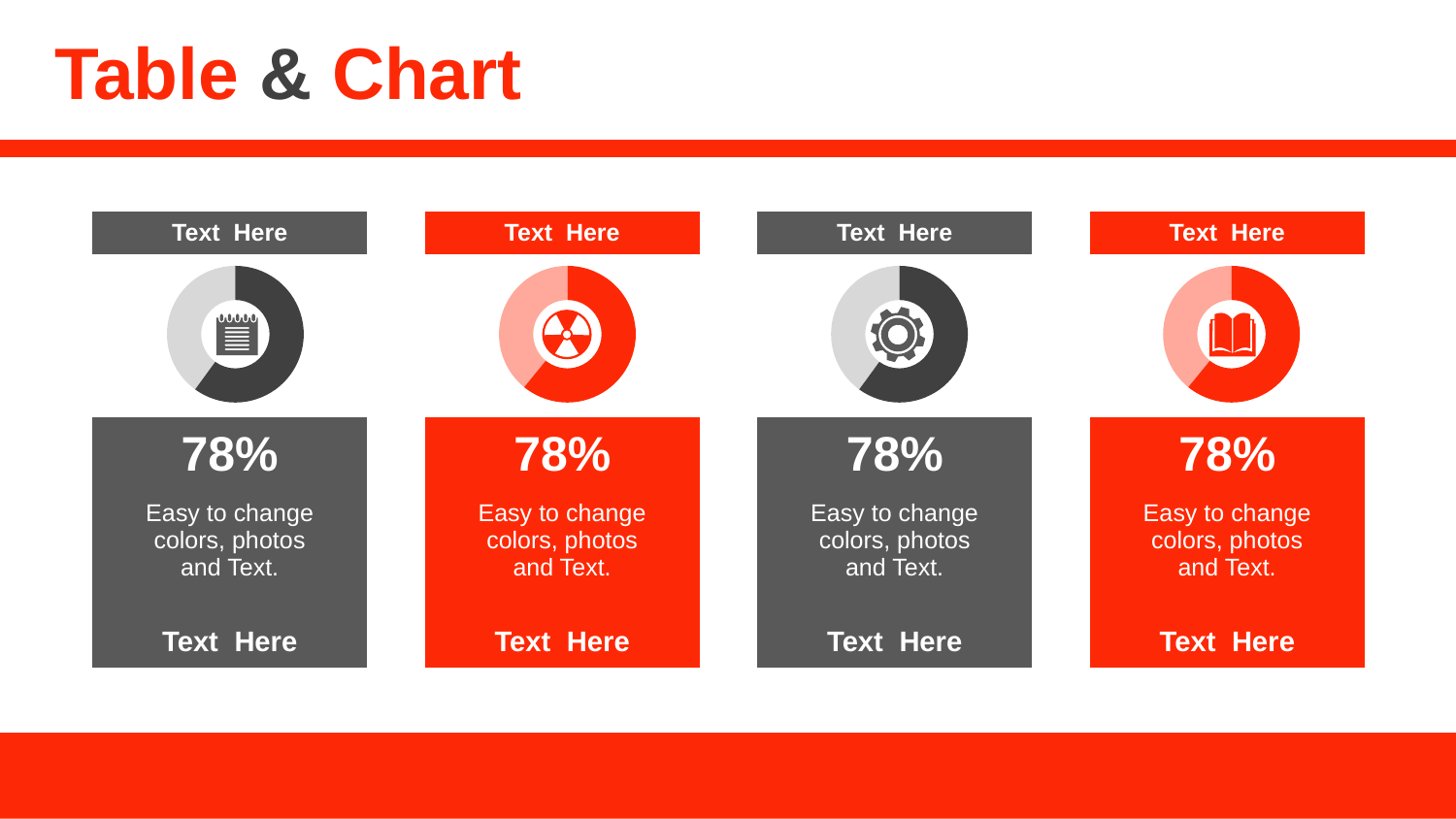
What is the header label printed above each donut chart? Text Here How many donut charts are shown on the slide? 4 How many segments does each donut chart have? 2 What colour is the larger segment of the second donut chart from the left? Red What percentage is printed below the leftmost donut chart? 78% Is the value shown for the leftmost donut chart greater or less than 50%? greater What percentage is printed below the third donut chart from the left? 78% What percentage is printed below the second donut chart from the left? 78% Do all four donut charts show the same percentage value? Yes What kind of chart is the leftmost chart on the slide? Donut chart What percentage is printed below the rightmost donut chart? 78%